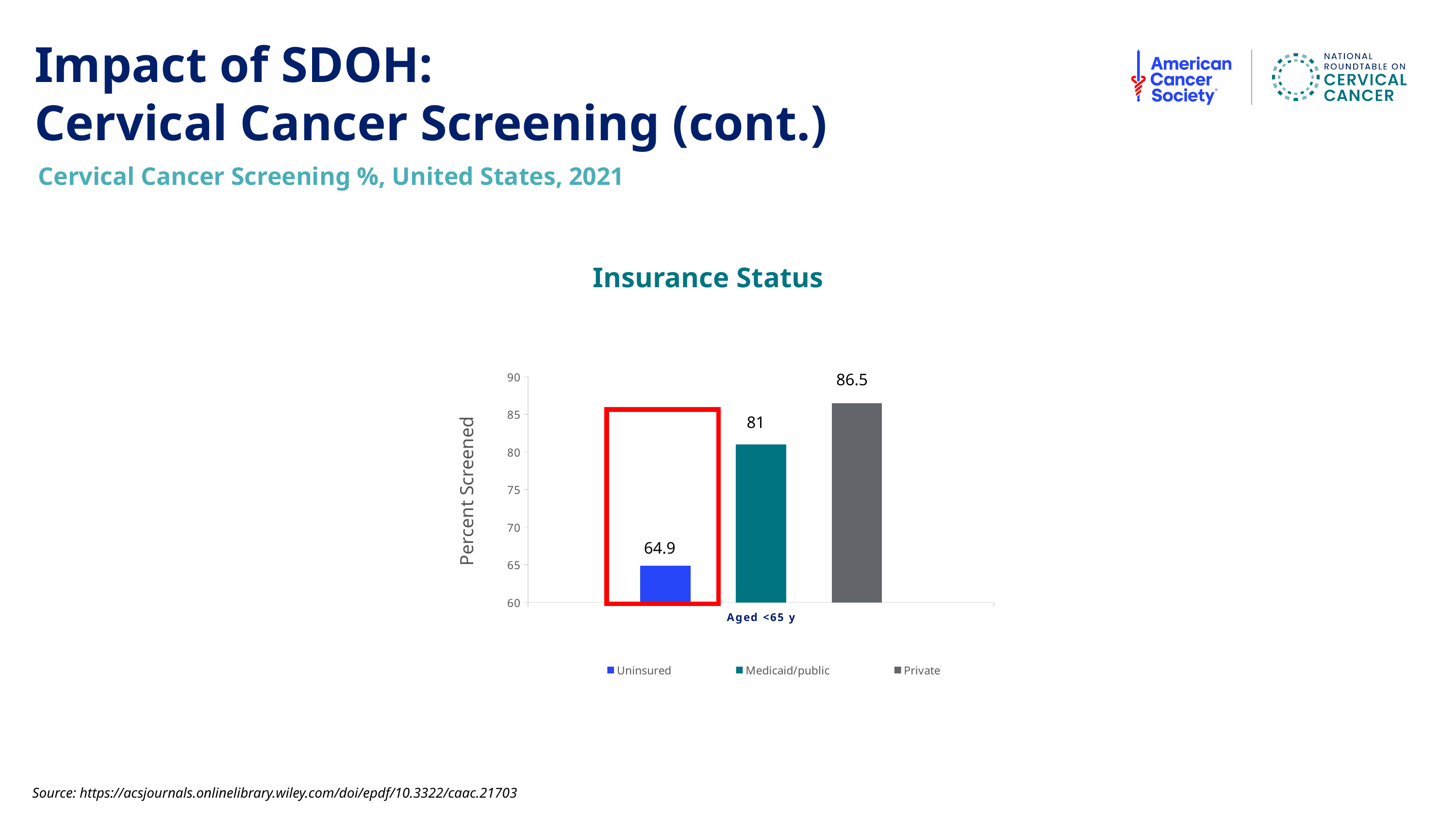
What is the title of the chart? Insurance Status Which has a higher percent screened, Medicaid/public or Private? Private What is the percent screened for the Uninsured group? 64.9 What is the percent screened for the Medicaid/public group? 81 How many series does the legend list? 3 What is the difference in percent screened between the Medicaid/public and Uninsured groups? 16.1 Is the value for Uninsured greater or less than 70? less Which insurance group has the lowest percent screened? Uninsured Which insurance group has the highest percent screened? Private What is the difference in percent screened between the Private and Uninsured groups? 21.6 What kind of chart is shown on the slide? Bar chart What is the percent screened for the Private insurance group? 86.5